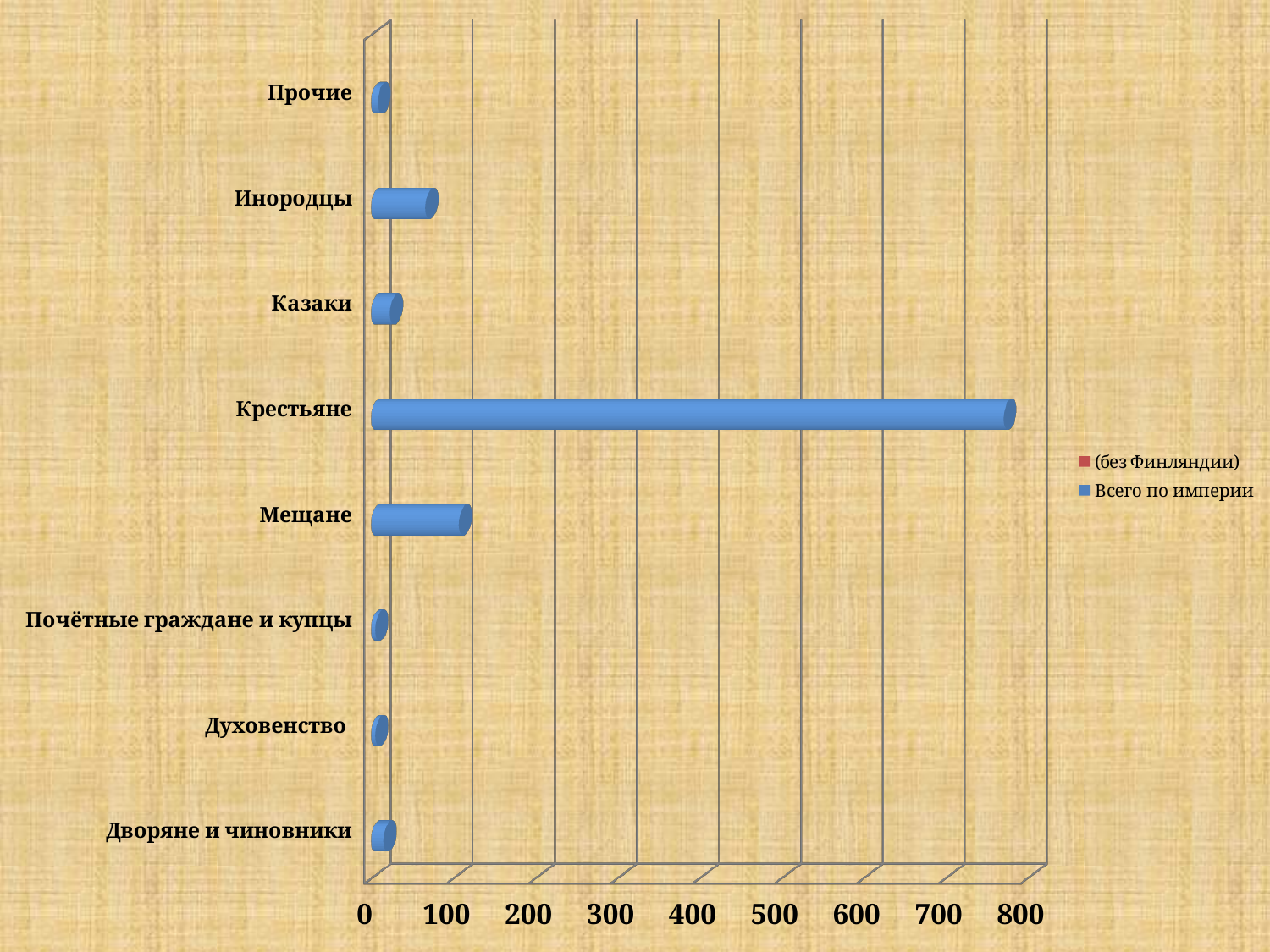
What kind of chart is shown on the slide? bar chart Which is larger, the value for Инородцы or the value for Казаки? Инородцы How many series does the legend list? 2 Which category has the highest value in the chart? Крестьяне Is the value for Казаки greater or less than 100? less Is the value for Инородцы greater or less than 100? less Which is larger, the value for Мещане or the value for Инородцы? Мещане What is the name of the series shown with blue bars in the legend? Всего по империи Is the value for Крестьяне greater or less than 700? greater What is the highest value shown on the horizontal axis of the chart? 800 How many categories are shown on the vertical axis of the chart? 8